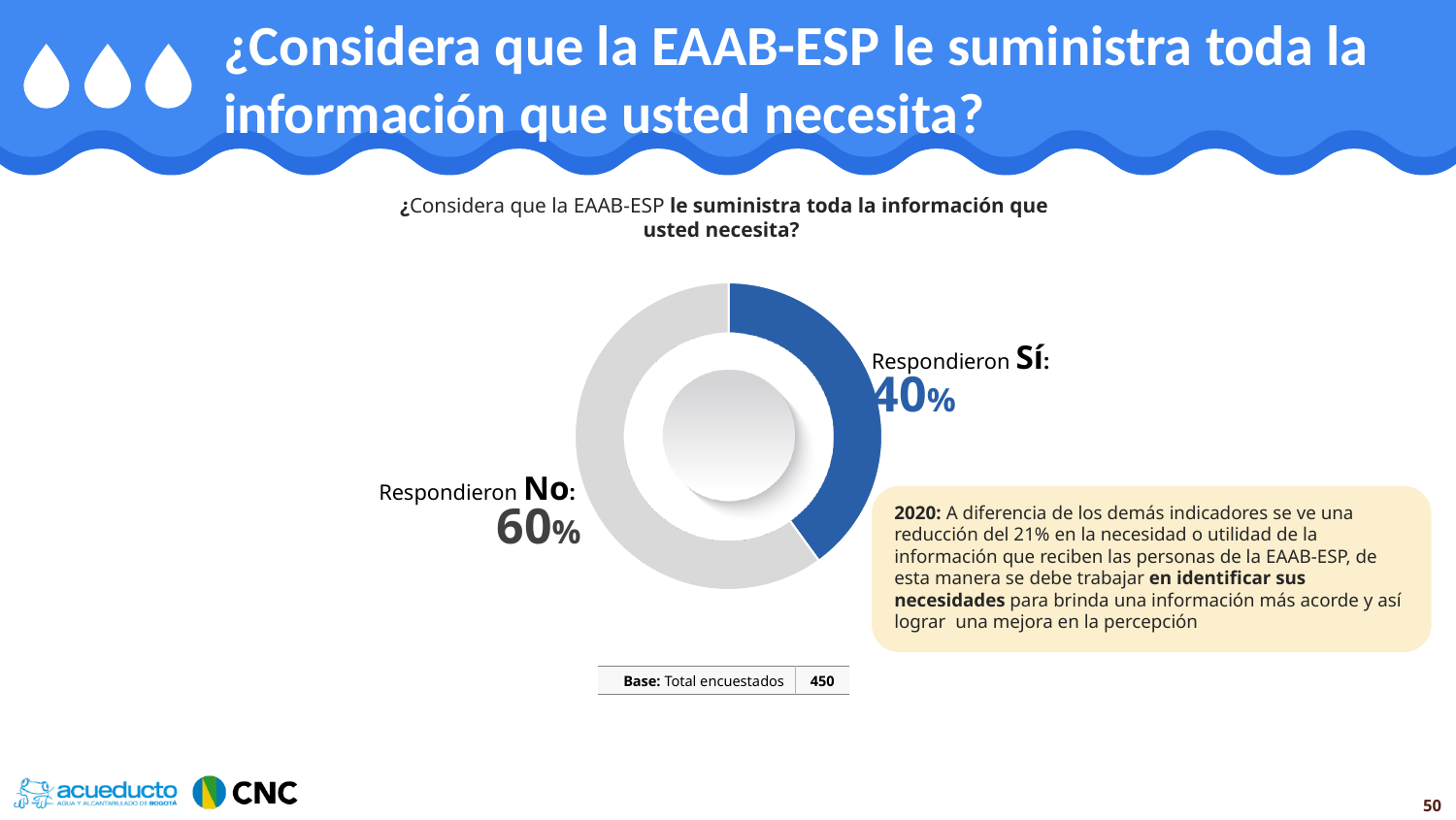
What percentage of respondents answered "No"? 60% What is the total of the two percentages shown in the chart? 100% What kind of chart is shown on the slide? Donut (pie) chart Is the share for "Sí" larger or smaller than the share for "No"? smaller What share of the chart does the "No" slice represent? 60% What colour is the slice representing "Sí"? Blue Which response has the larger share, "Sí" or "No"? No Which response has the smaller share, "Sí" or "No"? Sí What percentage of respondents answered "Sí"? 40% How many response categories does the chart show? 2 What is the base (total number of respondents) shown below the chart? 450 What is the difference in percentage points between the "No" and "Sí" responses? 20